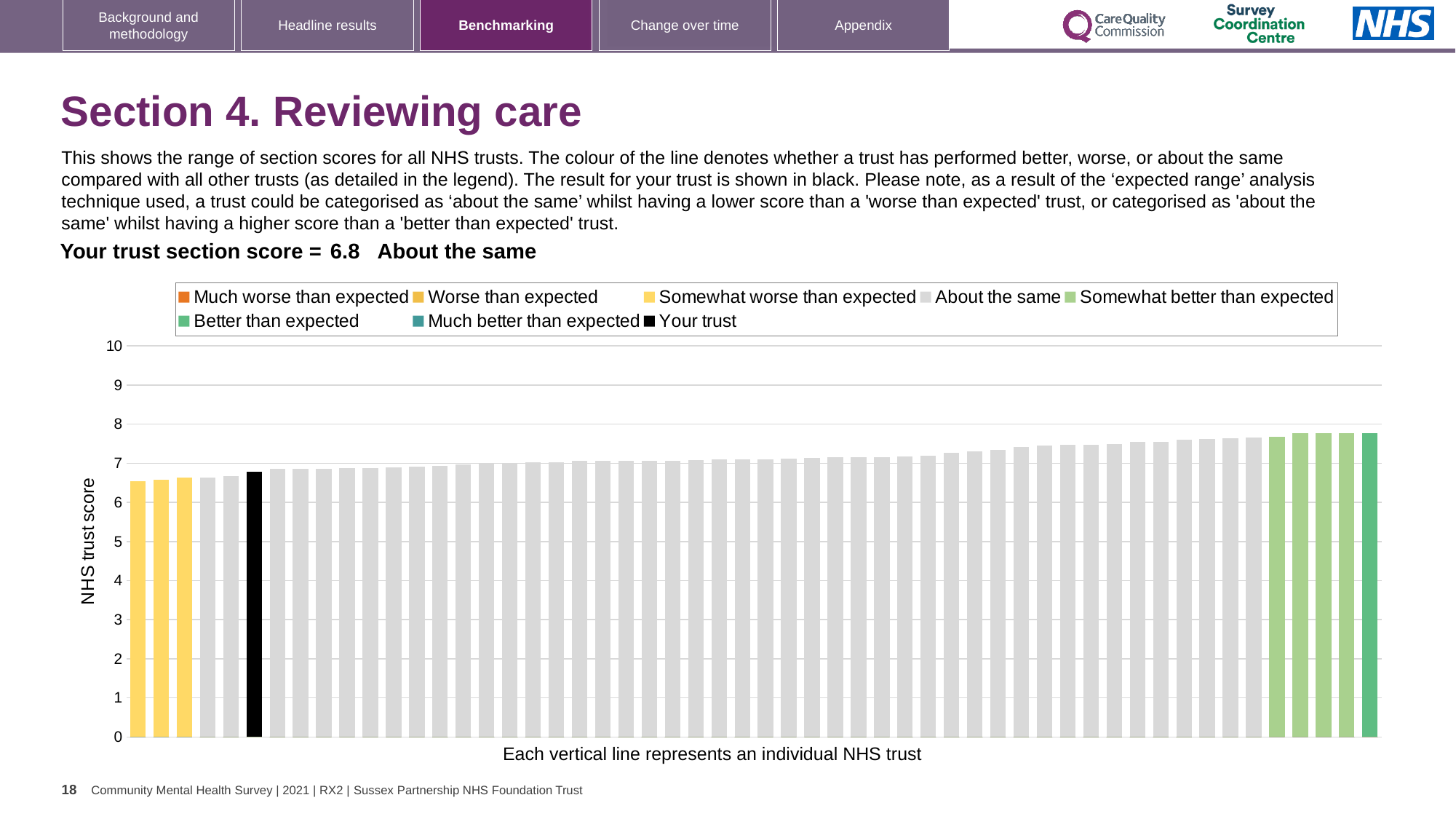
Is the value of the shortest bar in the chart greater or less than 6? greater Is the value of the tallest bar in the chart greater or less than 8? less Which category is your trust placed in for this section? About the same How many entries does the chart legend list? 8 What is the section score for your trust shown on the slide? 6.8 How many bars are coloured yellow (Somewhat worse than expected)? 3 Is the value of the black bar (your trust) greater or less than 5? greater Which is larger, the leftmost bar or the rightmost bar? the rightmost bar Do the bar values rise or fall from left to right along the x axis? rise What colour is the bar representing your trust? black What is the label on the vertical axis of the chart? NHS trust score What kind of chart is shown on the slide? bar chart